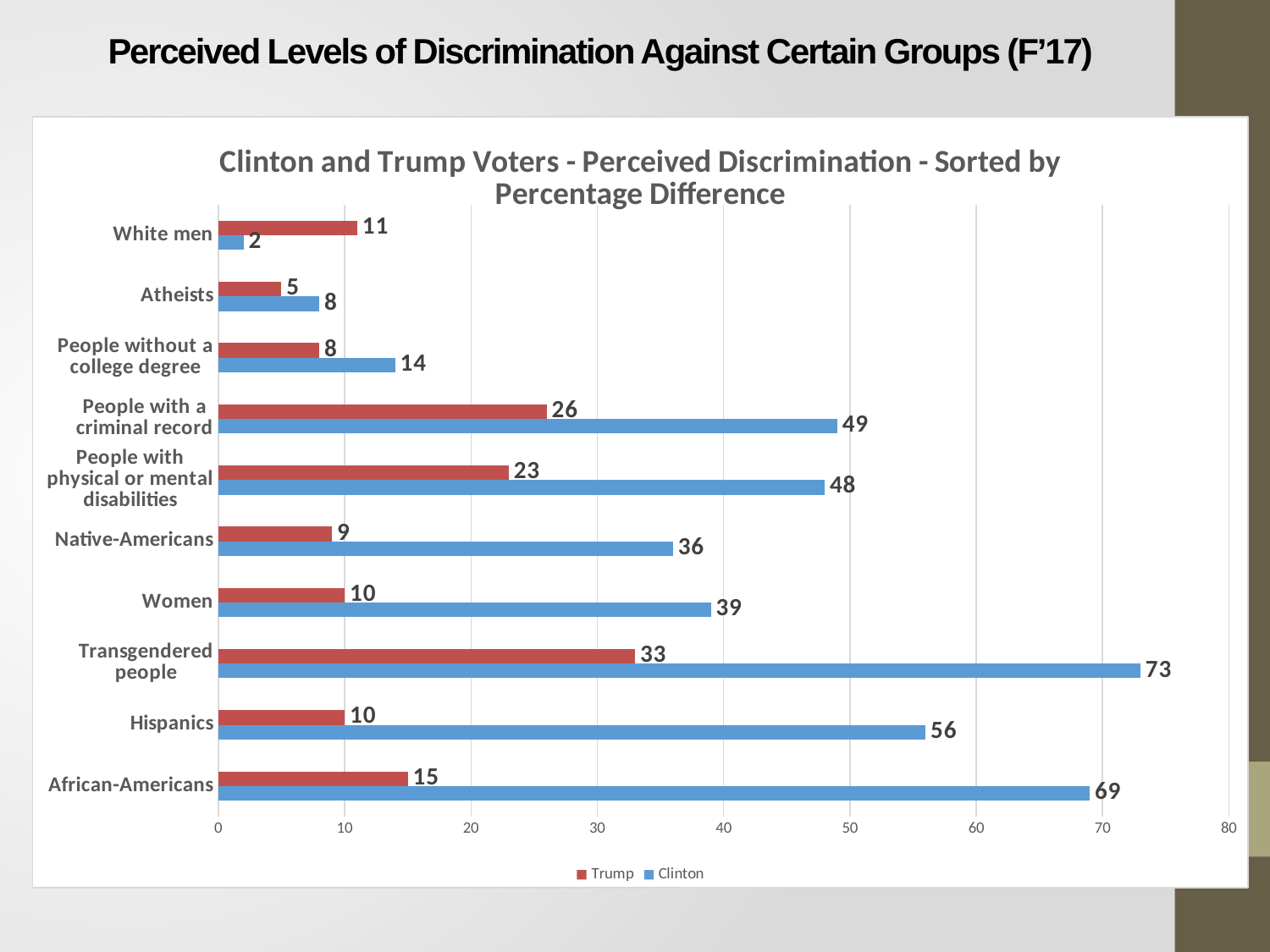
Which category has the highest Trump value? Transgendered people Which category has the highest Clinton value? Transgendered people Is the Clinton value for Women greater or less than 30? greater What is the Clinton value for Transgendered people? 73 What is the Clinton value for Native-Americans? 36 How many categories are shown on the chart? 10 What is the Trump value for African-Americans? 15 Which category has the lowest Clinton value? White men What kind of chart is shown on the slide? Bar chart How many series does the legend list? 2 Which is larger for White men, the Trump value or the Clinton value? Trump What is the difference between the Clinton and Trump values for Hispanics? 46